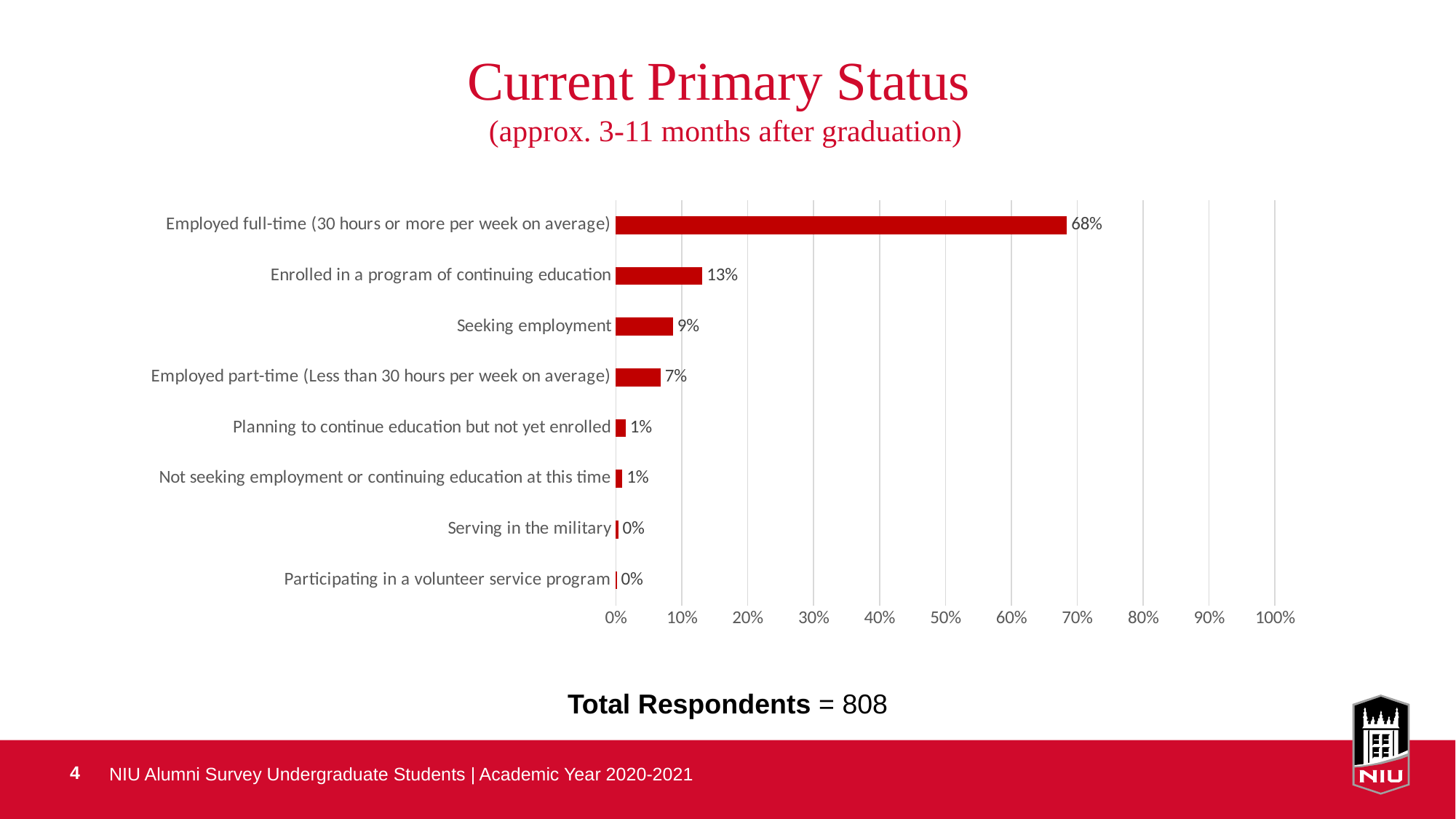
Which category has the highest value? Employed full-time (30 hours or more per week on average) Which is larger: the value for Seeking employment or the value for Employed part-time? Seeking employment What kind of chart is shown on the slide? Bar chart What is the value for Seeking employment? 9% How many categories are shown in the chart? 8 What is the value for Serving in the military? 0% What percentage of respondents are employed part-time (less than 30 hours per week on average)? 7% What is the difference between the values for Employed full-time and Enrolled in a program of continuing education? 55% What is the total number of respondents stated on the slide? 808 What percentage of respondents are employed full-time (30 hours or more per week on average)? 68% What percentage of respondents are enrolled in a program of continuing education? 13% Is the value for Employed full-time greater or less than 60%? greater